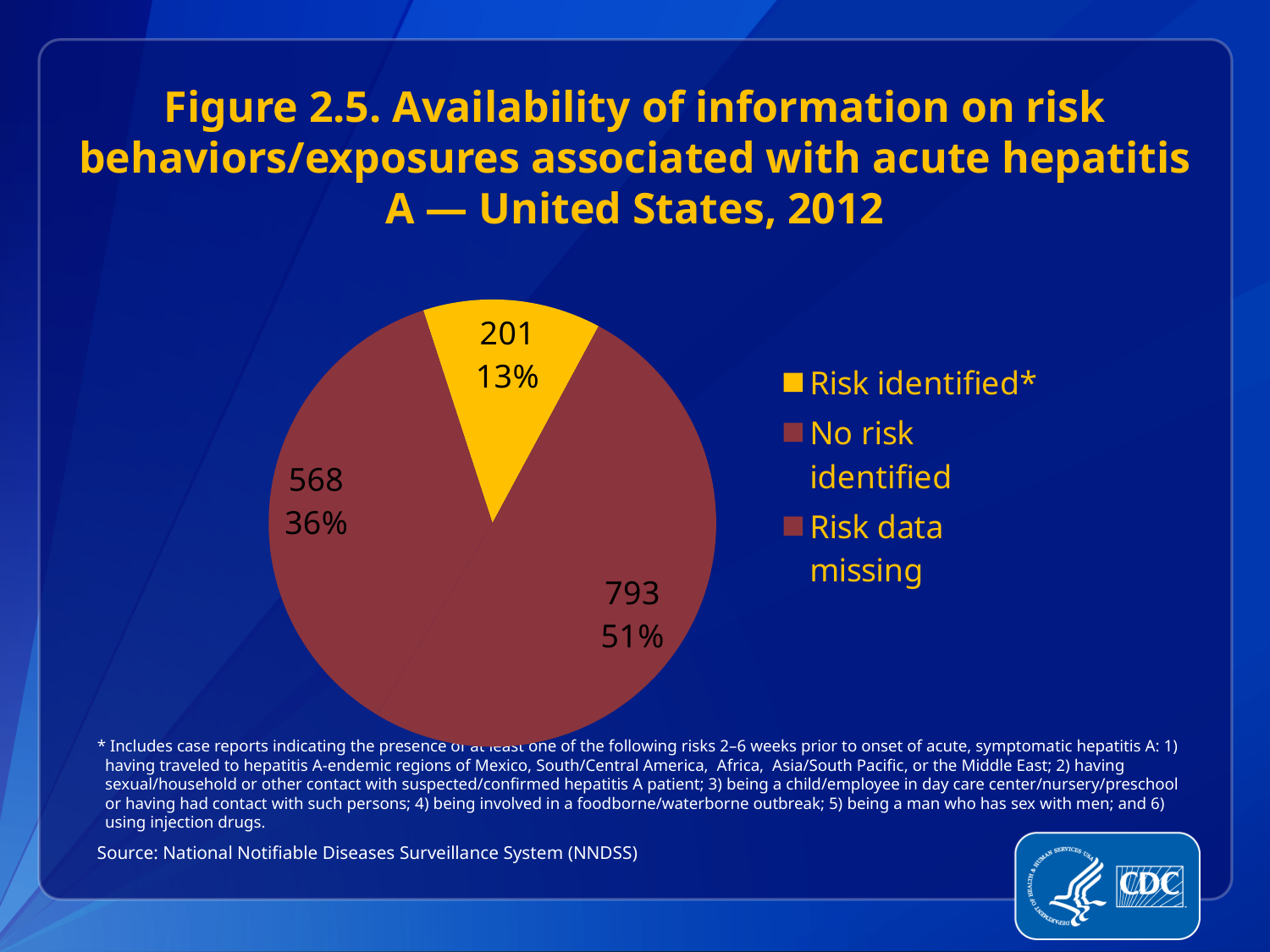
Which legend category corresponds to the smallest slice of the pie? Risk identified* What percentage is shown for the largest slice of the pie? 51% How many entries does the legend list? 3 What colour is the 'Risk identified*' slice in the pie chart? yellow Which is larger, the slice labeled 568 or the slice labeled 201? 568 What is the number of cases shown for the 'Risk identified*' slice? 201 How many slices does the pie chart have? 3 What is the total number of cases across all three slices of the pie? 1562 What kind of chart is shown on the slide? pie chart What is the largest value shown on the pie chart? 793 What share of the pie does the 'Risk identified*' slice represent? 13% What is the difference between the largest slice value (793) and the smallest slice value (201)? 592